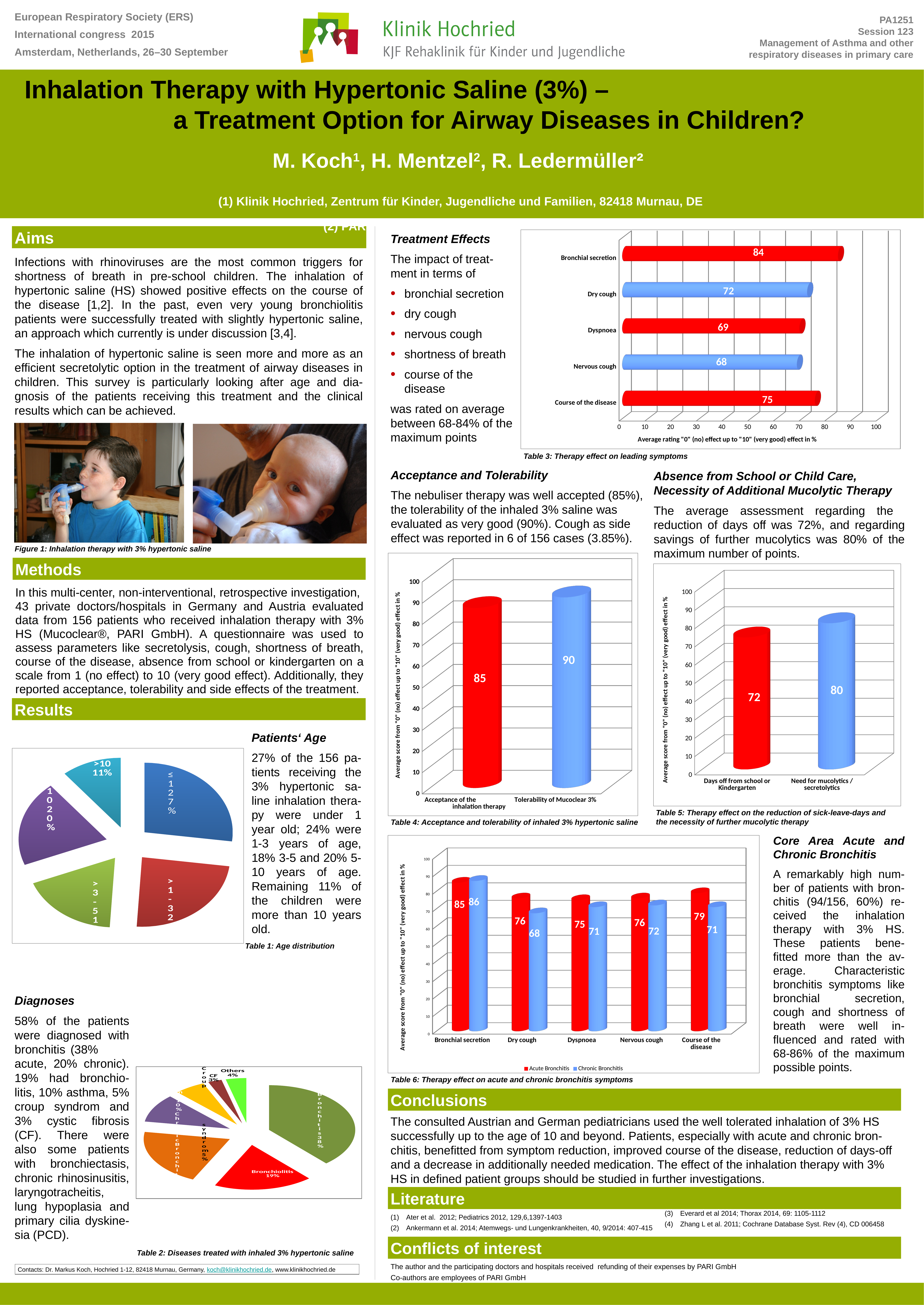
What type of chart is 'Table 3: Therapy effect on leading symptoms'? Bar chart How many series does the legend list in the chart 'Table 6: Therapy effect on acute and chronic bronchitis symptoms'? 2 In the chart 'Table 3: Therapy effect on leading symptoms', which symptom has the lowest value? Nervous cough In the pie chart 'Table 1: Age distribution', what share of patients were more than 10 years old (>10)? 11% How many symptom categories are shown in the chart 'Table 3: Therapy effect on leading symptoms'? 5 In the chart 'Table 6: Therapy effect on acute and chronic bronchitis symptoms', what is the difference between the Acute and Chronic Bronchitis values for Course of the disease? 8 In the chart 'Table 5', which is larger: Days off from school or Kindergarten, or Need for mucolytics / secretolytics? Need for mucolytics / secretolytics In the chart 'Table 4: Acceptance and tolerability of inhaled 3% hypertonic saline', what is the value for Tolerability of Mucoclear 3%? 90 In the chart 'Table 3: Therapy effect on leading symptoms', what is the difference between Bronchial secretion and Dry cough? 12 In the chart 'Table 3: Therapy effect on leading symptoms', what is the value for Bronchial secretion? 84 In the chart 'Table 6: Therapy effect on acute and chronic bronchitis symptoms', what is the Chronic Bronchitis value for Dry cough? 68 In the pie chart 'Table 2: Diseases treated with inhaled 3% hypertonic saline', what share is Bronchiolitis? 19%